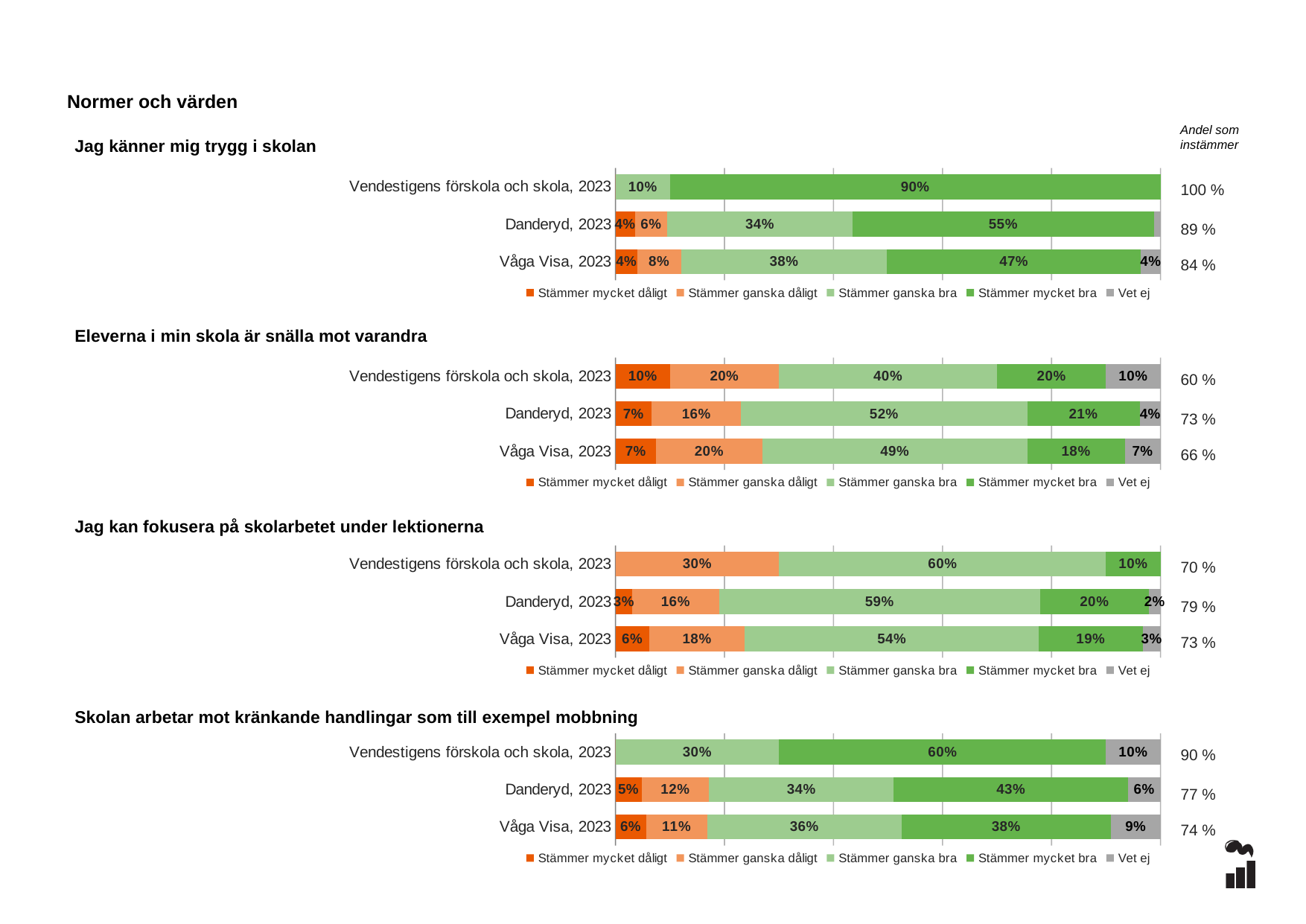
In the chart 'Skolan arbetar mot kränkande handlingar som till exempel mobbning', what is the 'Andel som instämmer' value for Vendestigens förskola och skola, 2023? 90 % How many series does the legend list in the chart 'Jag känner mig trygg i skolan'? 5 What kind of chart is used for 'Jag kan fokusera på skolarbetet under lektionerna'? Stacked bar chart In the chart 'Eleverna i min skola är snälla mot varandra', which row has the highest 'Stämmer ganska bra' value? Danderyd, 2023 In the chart 'Jag känner mig trygg i skolan', what is the 'Stämmer mycket bra' value for Vendestigens förskola och skola, 2023? 90% In the chart 'Jag kan fokusera på skolarbetet under lektionerna', what is the difference between the 'Stämmer ganska bra' values for Danderyd, 2023 and Våga Visa, 2023? 5% In the chart 'Skolan arbetar mot kränkande handlingar som till exempel mobbning', which is larger: the 'Stämmer mycket bra' value for Danderyd, 2023 or for Våga Visa, 2023? Danderyd, 2023 In the chart 'Skolan arbetar mot kränkande handlingar som till exempel mobbning', what is the 'Stämmer mycket bra' value for Danderyd, 2023? 43% In the chart 'Jag kan fokusera på skolarbetet under lektionerna', what is the 'Stämmer ganska dåligt' value for Vendestigens förskola och skola, 2023? 30% In the chart 'Eleverna i min skola är snälla mot varandra', what is the 'Vet ej' value for Vendestigens förskola och skola, 2023? 10% How many rows (categories) are shown in the chart 'Eleverna i min skola är snälla mot varandra'? 3 In the chart 'Jag känner mig trygg i skolan', what is the 'Stämmer ganska bra' value for Våga Visa, 2023? 38%